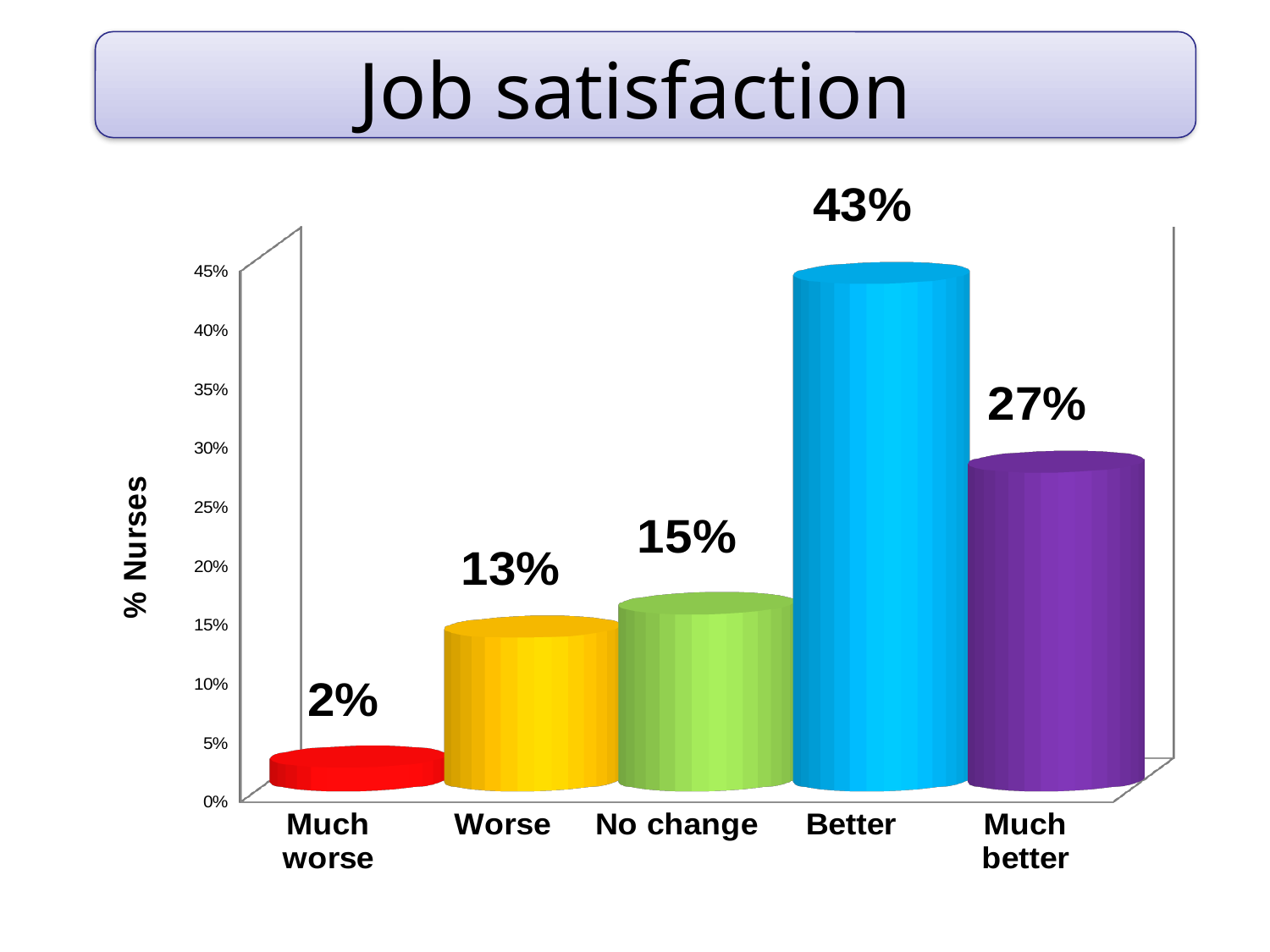
What is the value for 'No change'? 15% How many categories are shown on the x axis? 5 What is the label of the vertical axis? % Nurses Is the value for 'Much better' greater or less than 25%? greater Which is larger, the value for 'Worse' or the value for 'Much better'? Much better What percentage of nurses reported 'Better' job satisfaction? 43% What is the difference between the 'No change' and 'Worse' values? 2% What is the difference between the 'Better' and 'Much better' values? 16% What kind of chart is shown on the slide? Bar chart Which category has the lowest value? Much worse Which category has the highest value? Better What is the value for the 'Much worse' category? 2%